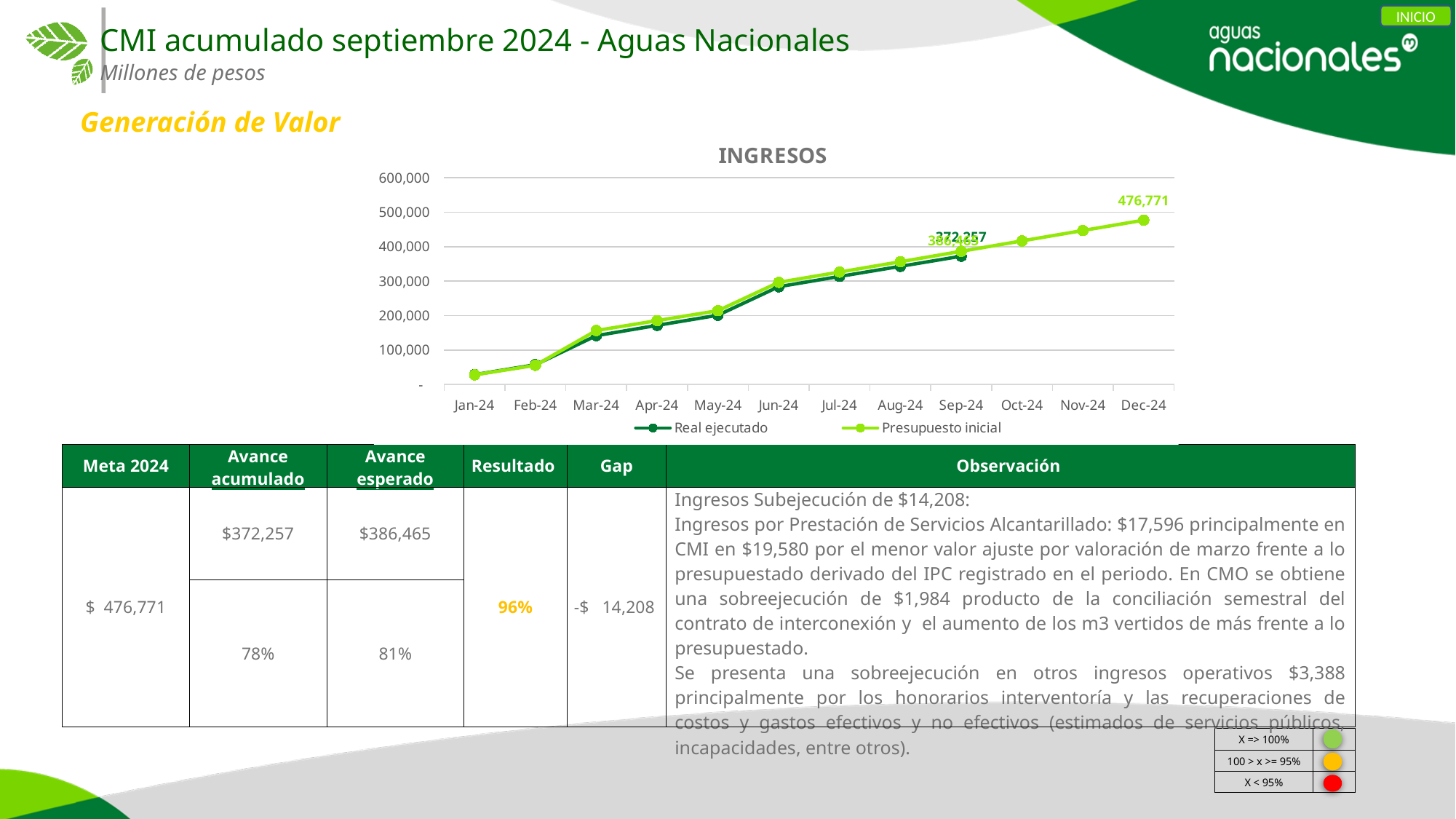
What kind of chart is the INGRESOS chart? line chart In the INGRESOS chart, is the Real ejecutado value for Jan-24 greater or less than 100,000? less How many months are shown on the x axis of the INGRESOS chart? 12 In the INGRESOS chart, is the Presupuesto inicial value for Jun-24 greater or less than 200,000? greater In the INGRESOS chart, what is the difference between Presupuesto inicial and Real ejecutado for Sep-24? 14,208 In the INGRESOS chart, which series has the larger value at Sep-24, Real ejecutado or Presupuesto inicial? Presupuesto inicial How many series does the legend of the INGRESOS chart list? 2 What is the Real ejecutado value for Sep-24 in the INGRESOS chart? 372,257 What is the Presupuesto inicial value for Sep-24 in the INGRESOS chart? 386,465 What is the Presupuesto inicial value for Dec-24 in the INGRESOS chart? 476,771 In which month does the Presupuesto inicial series reach its highest value in the INGRESOS chart? Dec-24 Do the values of the Presupuesto inicial series rise or fall from Jan-24 to Dec-24 in the INGRESOS chart? rise